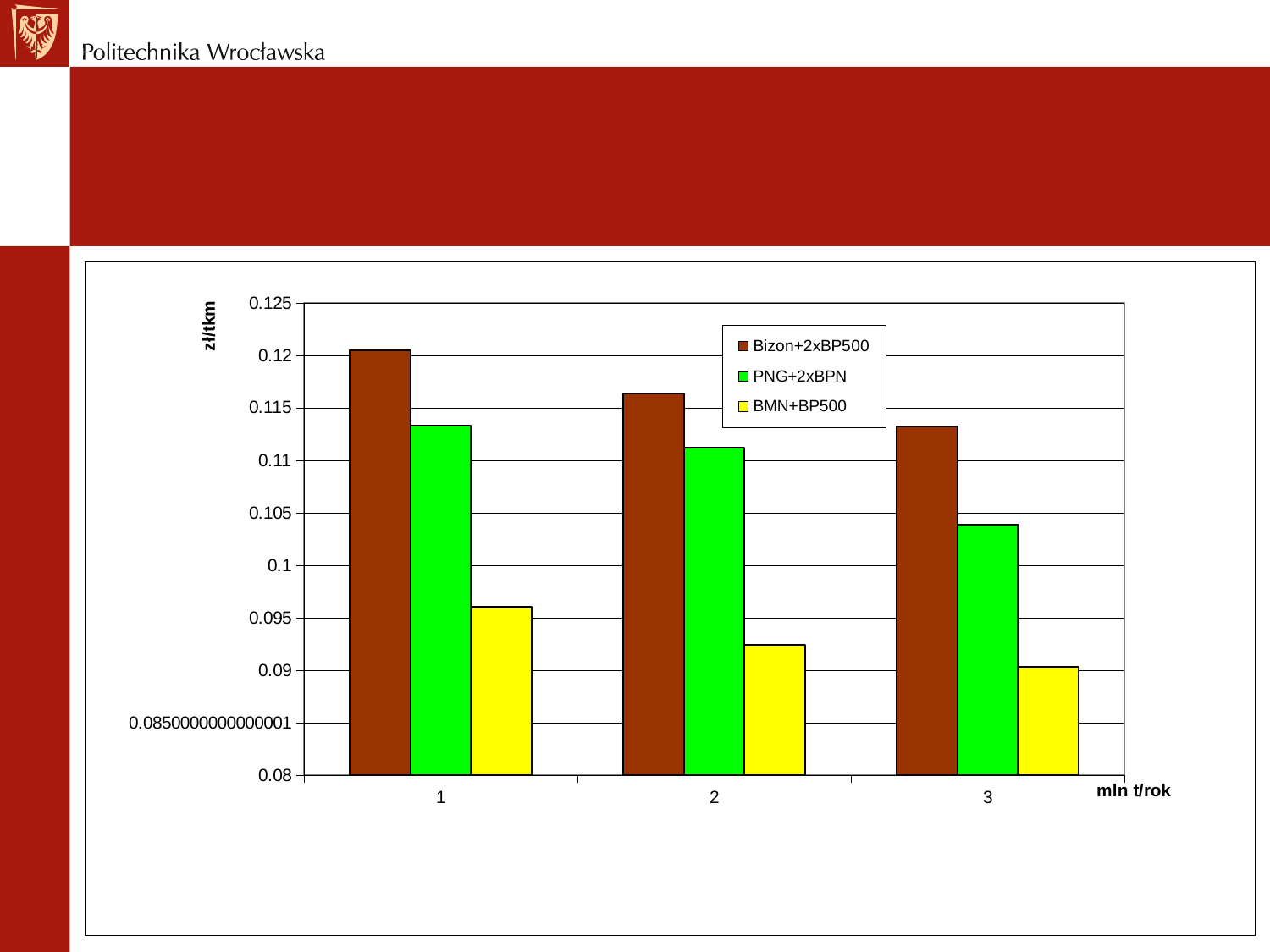
Do the values for Bizon+2xBP500 rise or fall from category 1 to category 3? fall Is the value for BMN+BP500 at category 2 greater or less than 0.095? less How many categories are shown on the x axis? 3 Which is larger at category 2: PNG+2xBPN or BMN+BP500? PNG+2xBPN Which series has the lowest value at category 3? BMN+BP500 What is the label of the y axis? zł/tkm How many series does the legend list? 3 Is the value for PNG+2xBPN at category 3 greater or less than 0.105? less At which category is the BMN+BP500 value highest? 1 Which series has the highest value at category 1? Bizon+2xBP500 What kind of chart is shown on the slide? bar chart